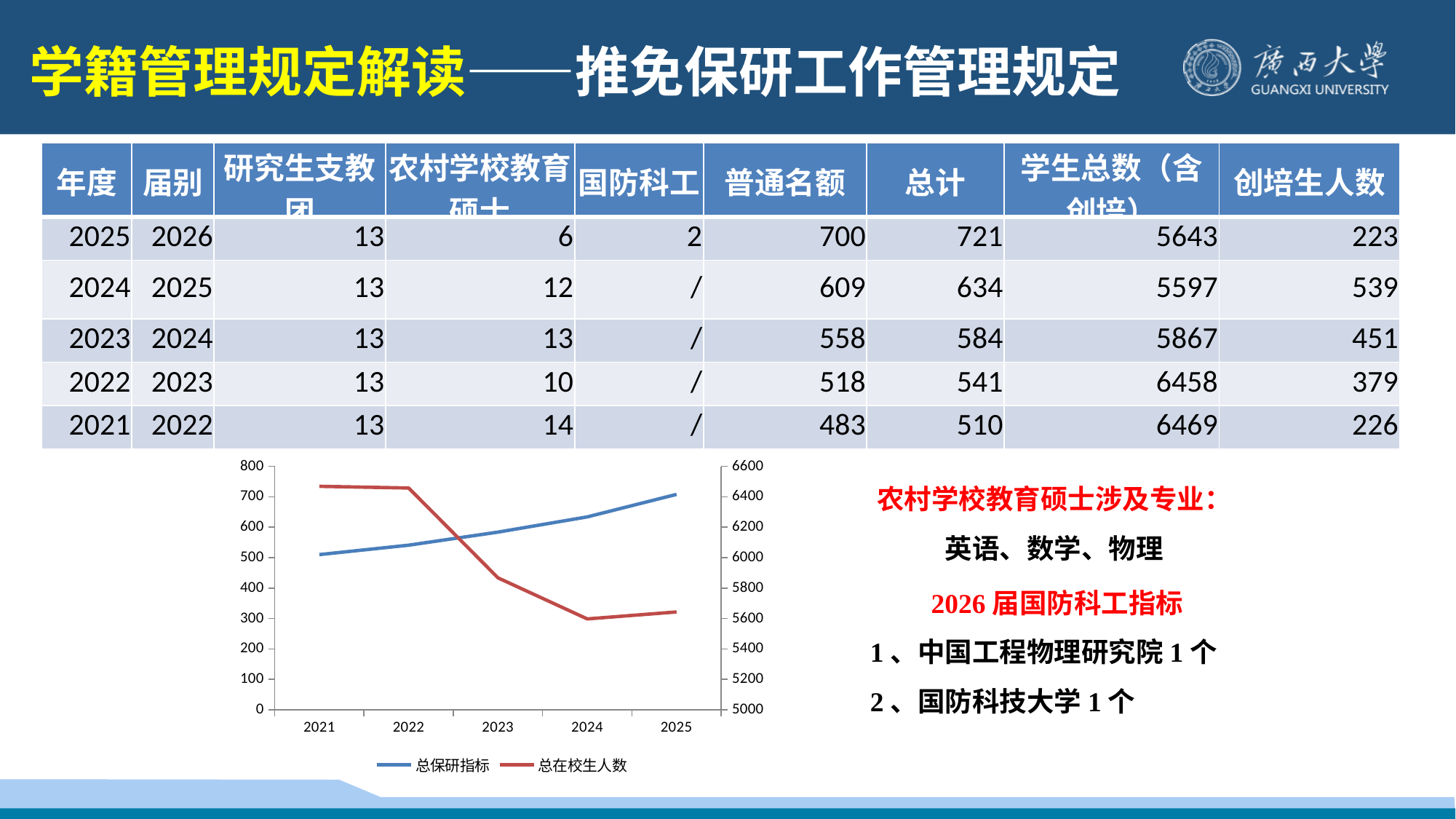
Does the 总保研指标 line rise or fall from 2021 to 2025? rises Does the 总在校生人数 line rise or fall from 2021 to 2025? falls In which year is the 总保研指标 line at its highest? 2025 Which year has the larger 总在校生人数 value, 2022 or 2023? 2022 Is the 总在校生人数 value for 2025 greater or less than 5800? less In which year is the 总保研指标 line at its lowest? 2021 What are the two legend entries of the chart? 总保研指标 and 总在校生人数 How many years are plotted along the x axis of the chart? 5 What kind of chart is shown on the slide? line chart How many series does the chart legend list? 2 Is the 总保研指标 value for 2025 greater or less than 600? greater Is the 总保研指标 value for 2021 greater or less than 600? less